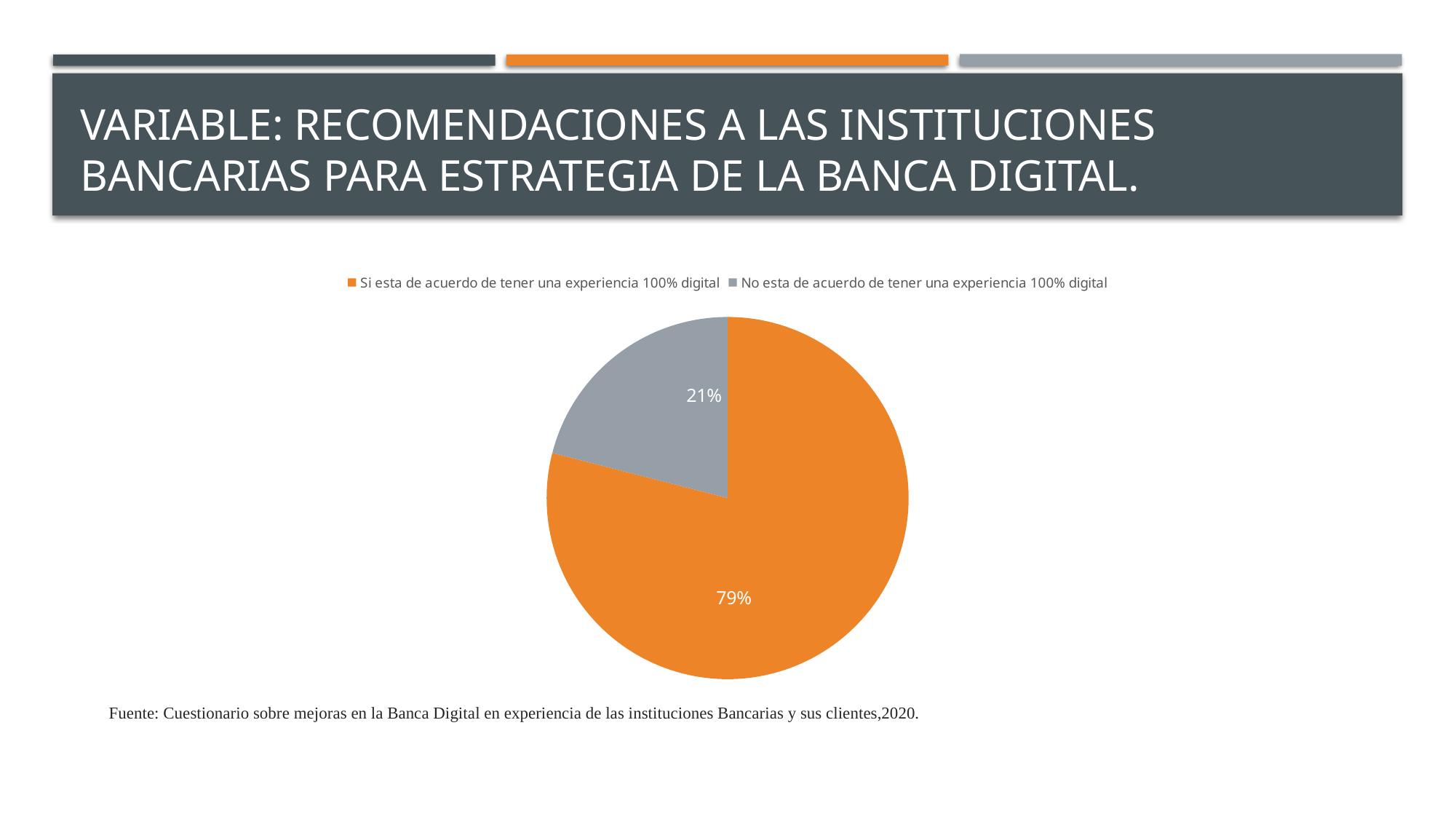
How many slices does the pie chart have? 2 What share of the pie is taken by the grey slice? 21% Which category has the largest share of the pie? Si esta de acuerdo de tener una experiencia 100% digital What is the difference in percentage points between the 'Si esta de acuerdo' slice and the 'No esta de acuerdo' slice? 58 What colour is the slice for 'Si esta de acuerdo de tener una experiencia 100% digital'? Orange What colour is the slice for 'No esta de acuerdo de tener una experiencia 100% digital'? Grey Which is larger: the share for 'Si esta de acuerdo de tener una experiencia 100% digital' or for 'No esta de acuerdo de tener una experiencia 100% digital'? Si esta de acuerdo de tener una experiencia 100% digital What percentage of the pie corresponds to 'No esta de acuerdo de tener una experiencia 100% digital'? 21% What kind of chart is shown on the slide? Pie chart What percentage of the pie corresponds to 'Si esta de acuerdo de tener una experiencia 100% digital'? 79% How many entries does the legend list? 2 Which category has the smallest share of the pie? No esta de acuerdo de tener una experiencia 100% digital